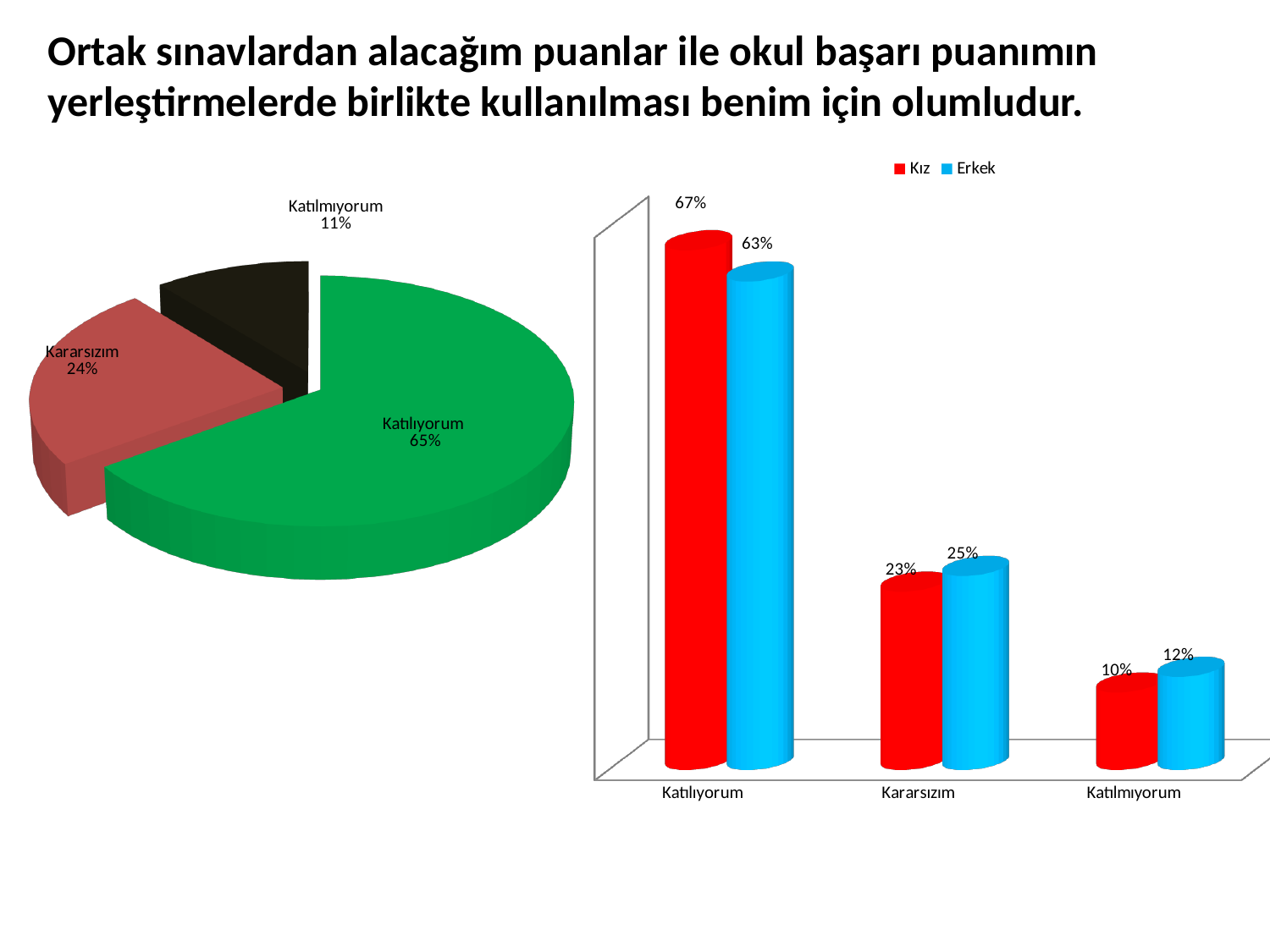
In the pie chart on the left, what share does Katılıyorum have? 65% In the bar chart on the right, what is the difference between Kız and Erkek in the Katılıyorum category? 4% In the bar chart on the right, what is the value for Erkek in the Kararsızım category? 25% What kind of chart is the chart on the left? pie chart In the pie chart on the left, which category has the smallest slice? Katılmıyorum In the pie chart on the left, how many slices are there? 3 In the pie chart on the left, what share does Kararsızım have? 24% In the bar chart on the right, which is larger in the Katılmıyorum category, Kız or Erkek? Erkek In the bar chart on the right, what is the value for Kız in the Katılmıyorum category? 10% In the bar chart on the right, what is the value for Kız in the Katılıyorum category? 67% In the bar chart on the right, do the Kız values rise or fall from Katılıyorum to Katılmıyorum? fall In the bar chart on the right, how many series does the legend list? 2